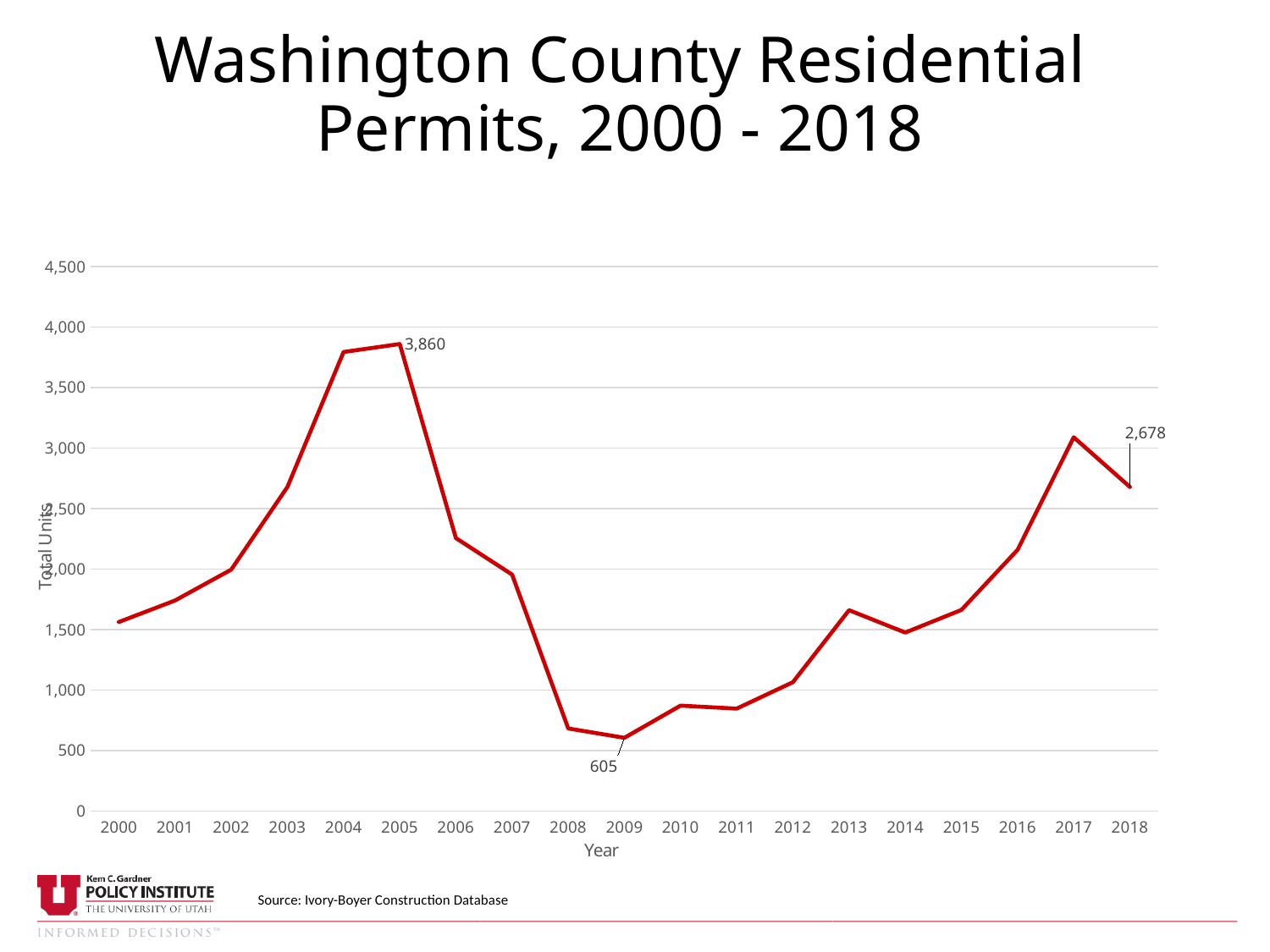
What is the value for 2009? 605 Which is larger, the value for 2005 or the value for 2018? 2005 What is the difference between the values for 2005 and 2009? 3,255 How many years are plotted on the chart? 19 Which year has the lowest number of residential permits? 2009 What is the value for 2005? 3,860 Which year has the highest number of residential permits? 2005 What kind of chart is shown on the slide? line chart Is the value for 2010 greater or less than 1,000? less Is the value for 2004 greater or less than 3,500? greater What is the difference between the values for 2005 and 2018? 1,182 What is the value for 2018? 2,678